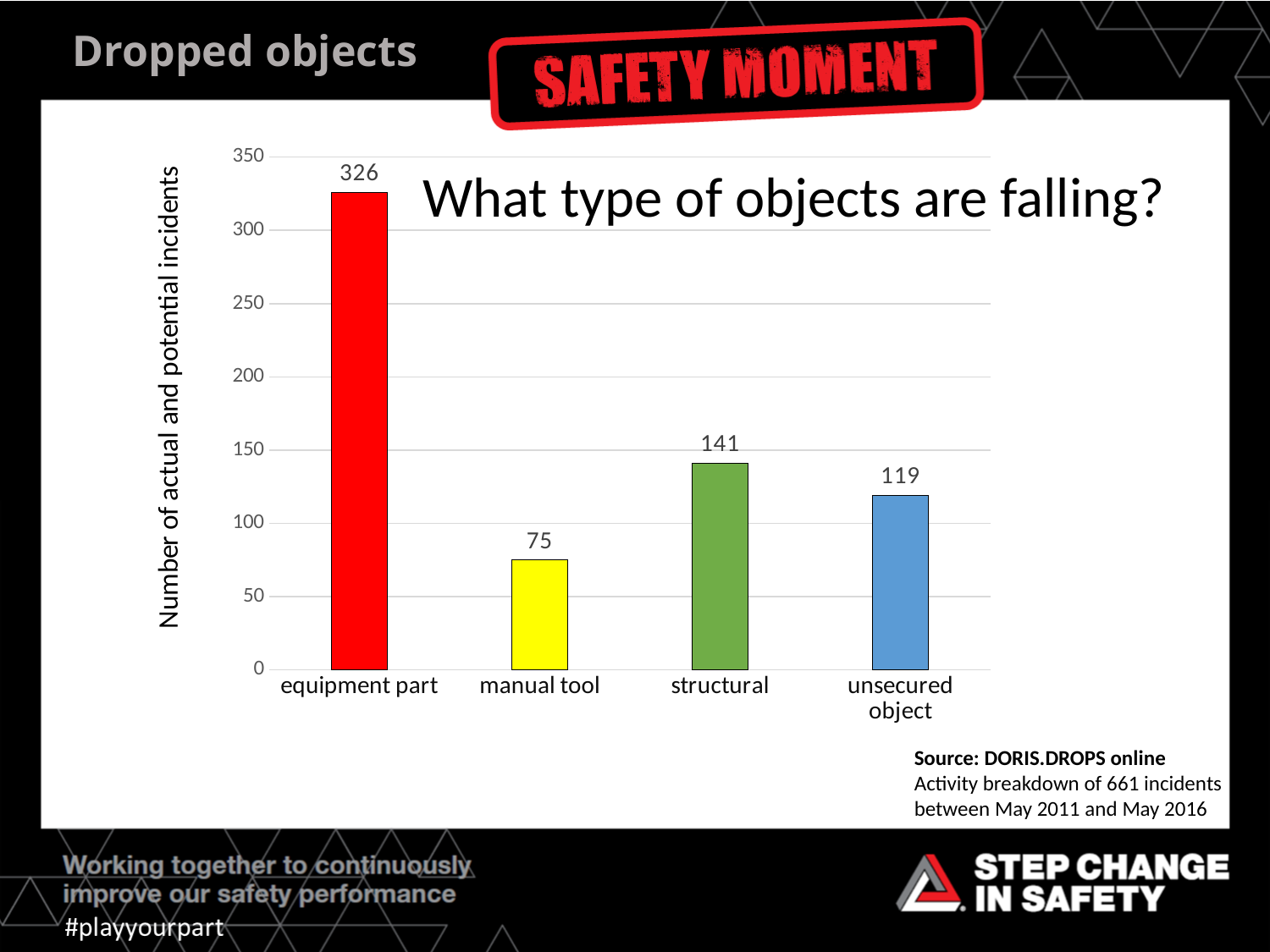
What is the number of incidents for structural? 141 How many categories are shown on the chart? 4 Which has more incidents, structural or unsecured object? structural What is the difference between the incidents for equipment part and structural? 185 What is the difference between the incidents for structural and unsecured object? 22 What kind of chart is shown on the slide? bar chart Which category has the lowest number of incidents? manual tool What is the number of incidents for equipment part? 326 What is the number of incidents for unsecured object? 119 What is the label of the vertical axis? Number of actual and potential incidents What is the number of incidents for manual tool? 75 Which category has the highest number of incidents? equipment part